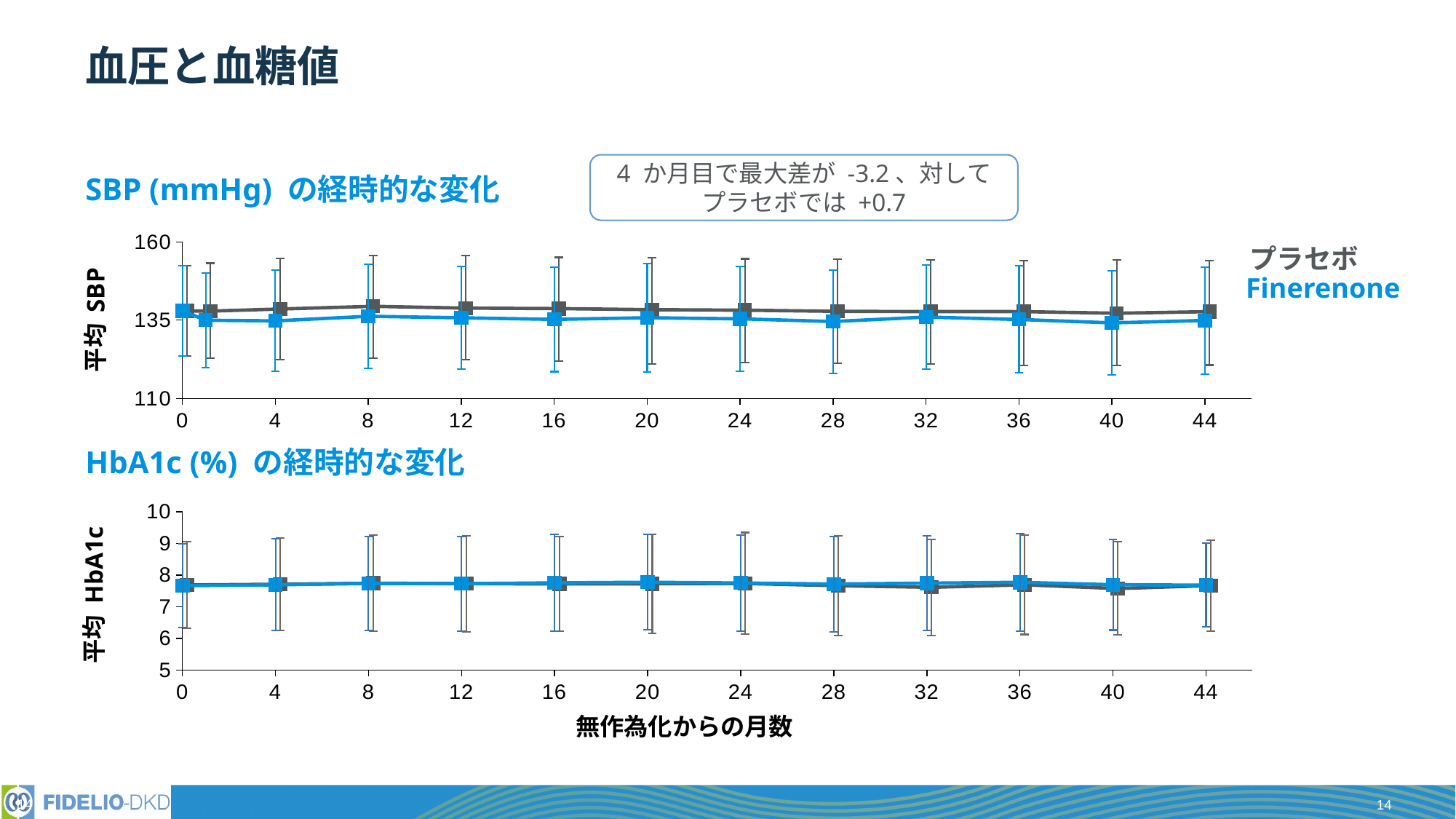
What kind of chart is the top chart, 'SBP (mmHg) の経時的な変化'? line chart According to the annotation on the SBP chart, at which month is the maximum difference of -3.2 observed? 4 か月目 In the SBP chart, does the Finerenone line rise or fall from month 0 to month 4? fall In the HbA1c chart, is the プラセボ value at month 0 greater or less than 7? greater What is the x-axis label shared by the two charts? 無作為化からの月数 In the SBP chart, is the Finerenone value at month 0 greater or less than 135? greater In the SBP chart, is the プラセボ value at month 8 greater or less than 135? greater In the SBP chart, at month 4, which series has the higher value, プラセボ or Finerenone? プラセボ Which series is drawn in blue in the charts? Finerenone How many series are shown in the legend for the charts? 2 How many labelled tick marks are on the x axis of the HbA1c chart? 12